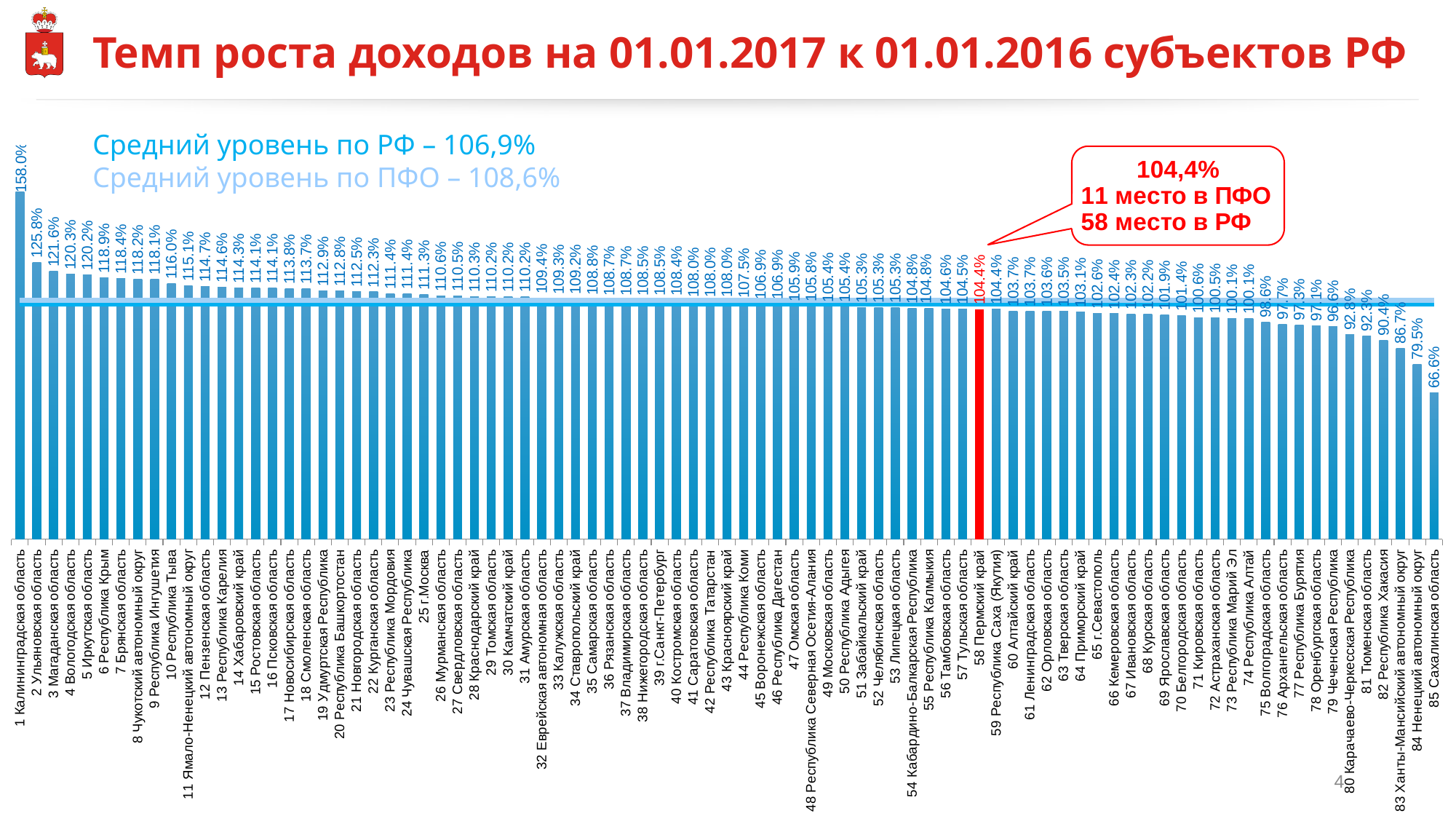
Which region has the lowest income growth rate on the chart? 85 Сахалинская область According to the slide, what is the average level for the Russian Federation (РФ)? 106,9% Which region has the highest income growth rate on the chart? 1 Калининградская область What kind of chart is shown on the slide? bar chart Which has a higher value: г.Москва or Республика Татарстан? г.Москва What is the value shown for Калининградская область? 158.0% What is the value shown for Сахалинская область? 66.6% Do the values rise or fall moving from left to right along the x axis? fall What is the value shown for г.Москва? 111.3% What is the value shown for Пермский край (the red bar)? 104.4% What is the difference between the values for Калининградская область and Сахалинская область? 91.4 percentage points How many regions (bars) are shown on the chart? 85